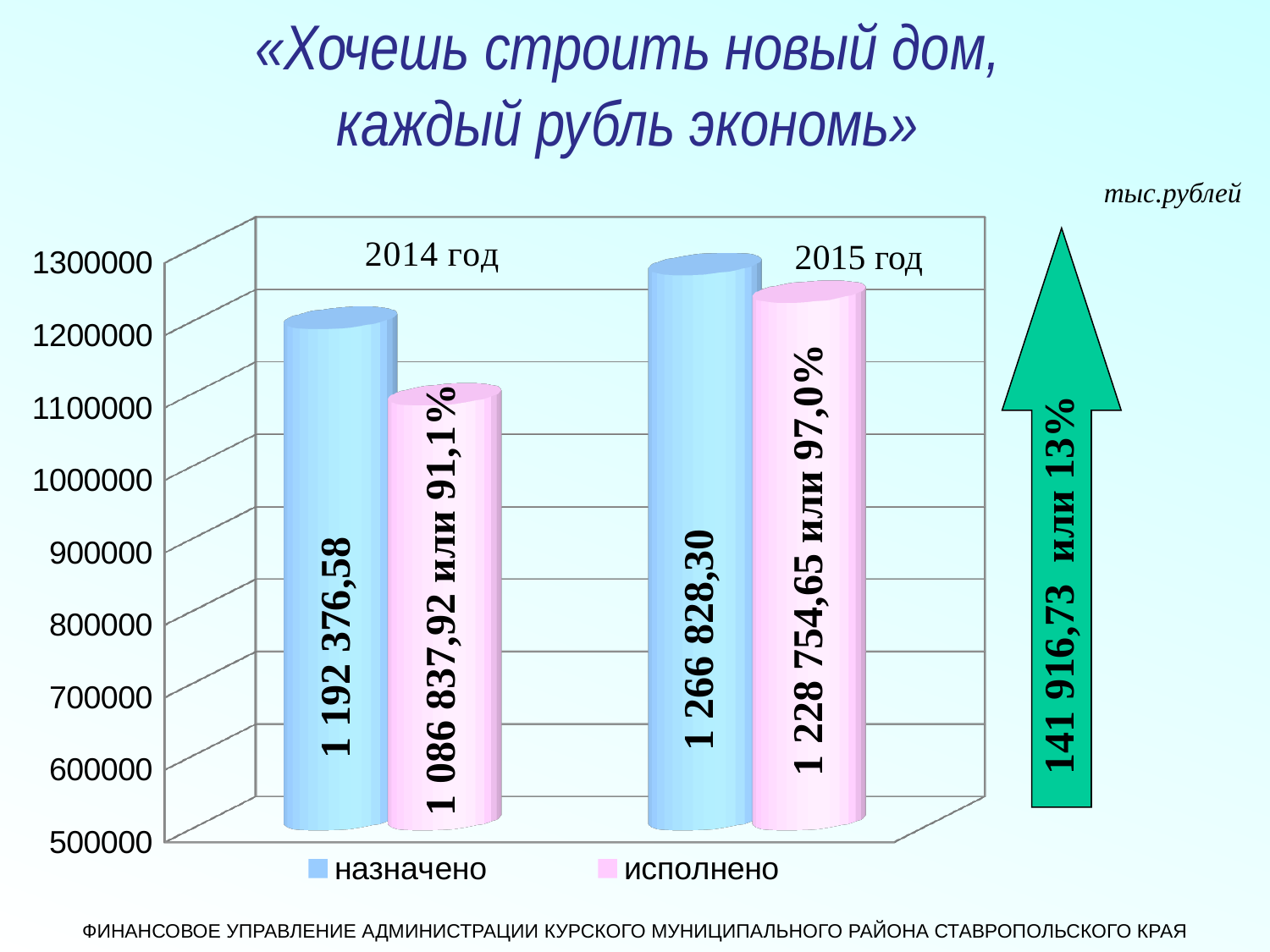
What unit is indicated for the chart values? тыс.рублей What is the difference between исполнено for 2015 год and исполнено for 2014 год? 141 916,73 What kind of chart is shown on the slide? bar chart Which bar is the lowest on the chart? исполнено, 2014 год What is the difference between назначено and исполнено for 2015 год? 38 073,65 What percentage is shown on the исполнено bar for 2014 год? 91,1% Which bar is the highest on the chart? назначено, 2015 год What percentage is shown on the исполнено bar for 2015 год? 97,0% Which is larger: назначено for 2014 год or исполнено for 2015 год? исполнено for 2015 год How many series does the legend list? 2 What is the value of назначено for 2014 год? 1 192 376,58 What is the value of исполнено for 2015 год? 1 228 754,65